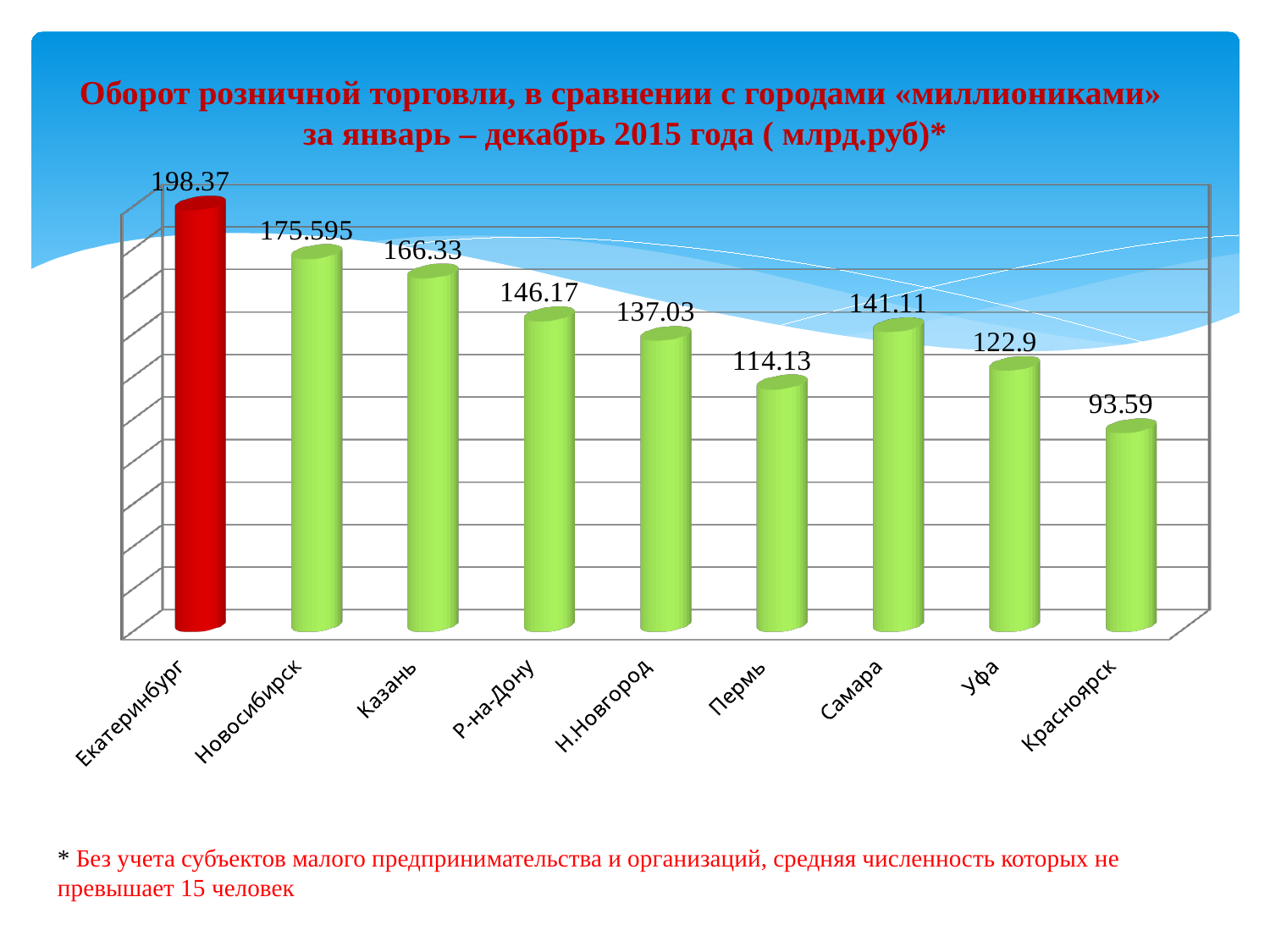
What kind of chart is shown on the slide? Bar chart What is the value for Новосибирск? 175.595 Which city has the lowest value? Красноярск What is the value for Самара? 141.11 Which city's bar is coloured red? Екатеринбург What is the difference between the values for Самара and Пермь? 26.98 What is the value for Екатеринбург? 198.37 What is the difference between the values for Екатеринбург and Красноярск? 104.78 How many cities are shown in the chart? 9 Which city has the highest value? Екатеринбург What is the value for Красноярск? 93.59 Which is larger, the value for Уфа or the value for Пермь? Уфа